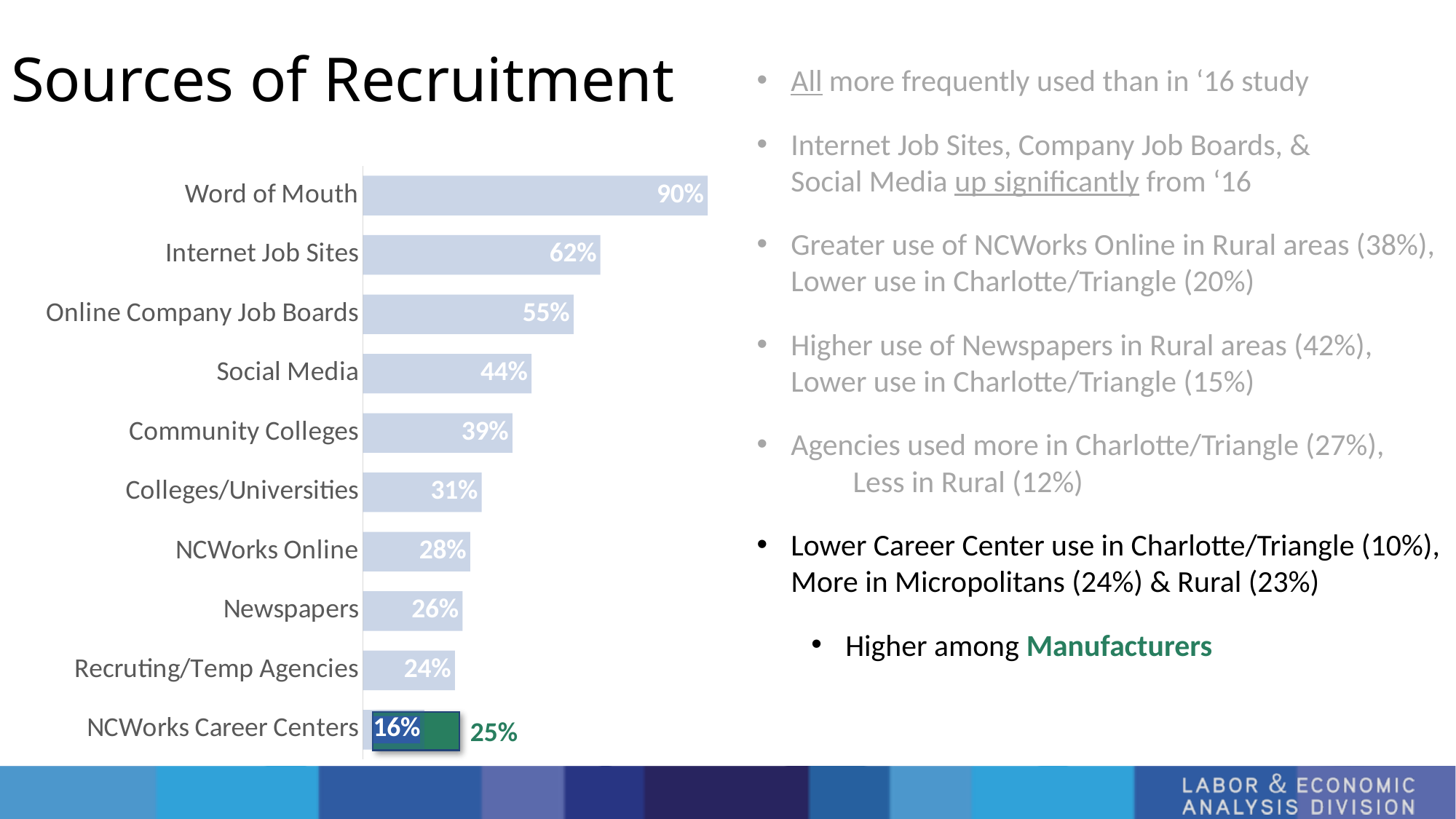
Which is larger, Community Colleges or Colleges/Universities? Community Colleges What is the difference between Word of Mouth and Newspapers? 64% Which source of recruitment has the lowest value in the main (light blue) bars? NCWorks Career Centers What value is shown in green next to the NCWorks Career Centers bar? 25% What is the value for Recruiting/Temp Agencies? 24% How many recruitment sources are listed on the chart? 10 What is the value for Social Media? 44% Which source of recruitment has the highest value? Word of Mouth What type of chart is shown on the slide? Bar chart What percentage is shown for Word of Mouth? 90% What is the difference between Internet Job Sites and Online Company Job Boards? 7% What percentage is shown for NCWorks Online? 28%